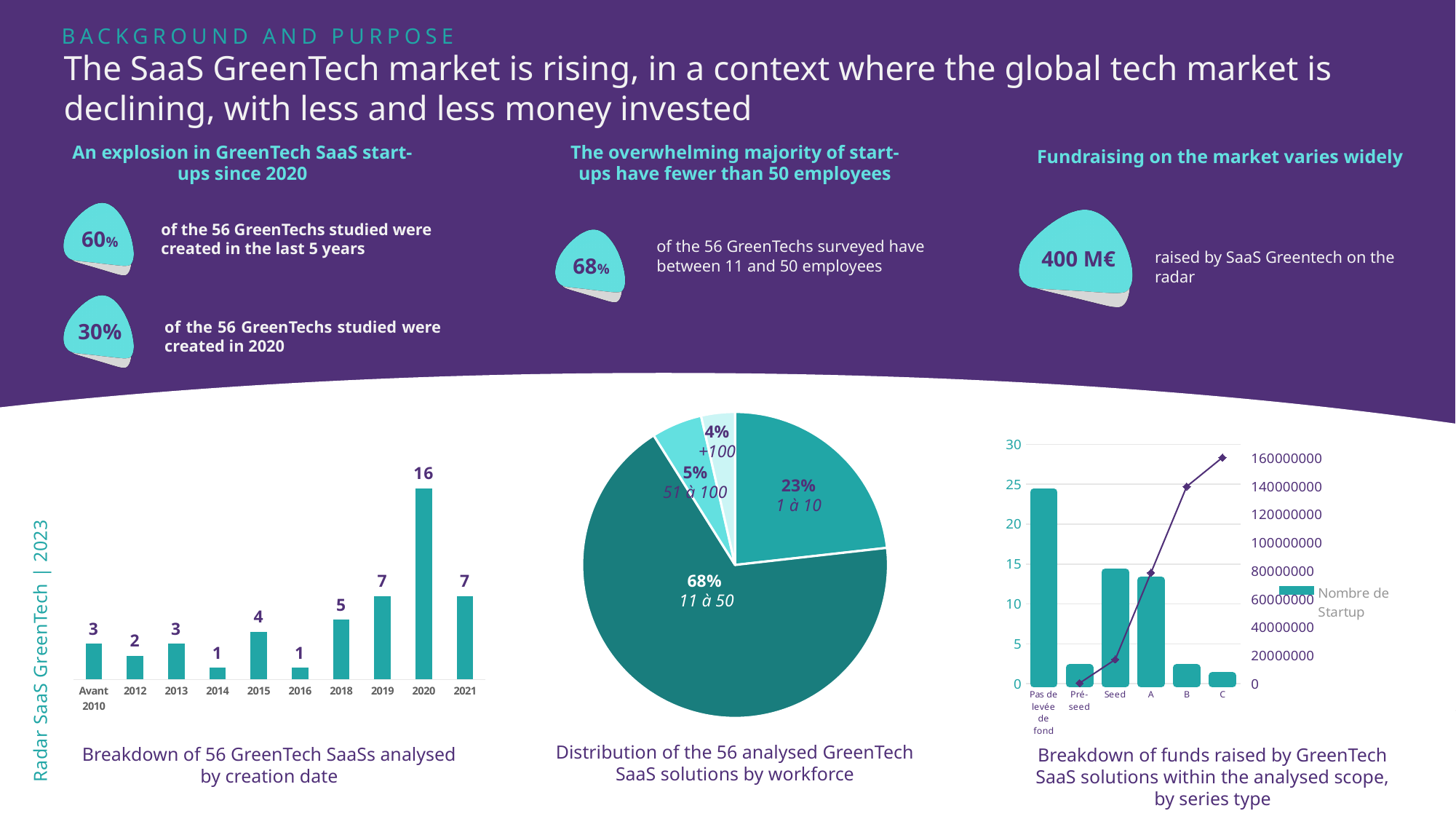
In the pie chart 'Distribution of the 56 analysed GreenTech SaaS solutions by workforce', what share do companies with 11 à 50 employees represent? 68% In the chart 'Breakdown of 56 GreenTech SaaSs analysed by creation date', which is larger, the value for 2015 or the value for 2018? 2018 In the chart 'Breakdown of funds raised by GreenTech SaaS solutions within the analysed scope, by series type', is the number of startups for 'Pas de levée de fond' greater or less than 20? greater In the chart 'Breakdown of 56 GreenTech SaaSs analysed by creation date', how many GreenTech SaaSs were created in 2020? 16 In the chart 'Breakdown of funds raised by GreenTech SaaS solutions within the analysed scope, by series type', is the number of startups for 'C' greater or less than 5? less In the chart 'Breakdown of 56 GreenTech SaaSs analysed by creation date', which year has the highest number of GreenTech SaaSs created? 2020 How many slices does the pie chart 'Distribution of the 56 analysed GreenTech SaaS solutions by workforce' have? 4 What kind of chart is 'Breakdown of 56 GreenTech SaaSs analysed by creation date'? bar chart In the chart 'Breakdown of 56 GreenTech SaaSs analysed by creation date', how many categories are shown on the x axis? 10 In the pie chart 'Distribution of the 56 analysed GreenTech SaaS solutions by workforce', which workforce category has the smallest share? +100 In the chart 'Breakdown of 56 GreenTech SaaSs analysed by creation date', what is the difference between the values for 2020 and 2021? 9 In the chart 'Breakdown of funds raised by GreenTech SaaS solutions within the analysed scope, by series type', what series name does the legend show? Nombre de Startup